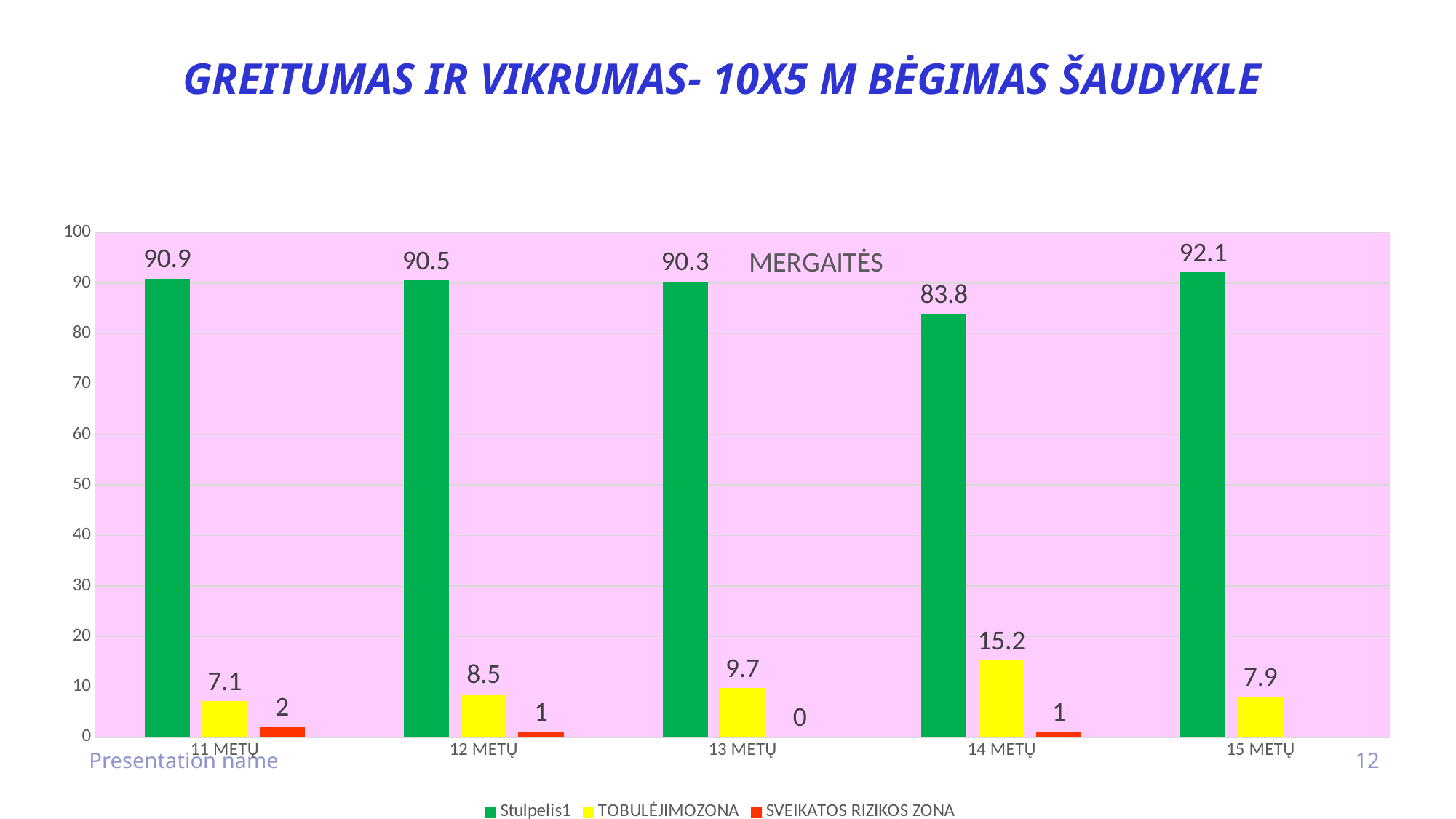
How many age groups are shown on the x axis? 5 Which age group has the highest Stulpelis1 value? 15 METŲ What colour are the TOBULĖJIMOZONA bars? Yellow What is the TOBULĖJIMOZONA value for 14 METŲ? 15.2 Which age group has the lowest Stulpelis1 value? 14 METŲ Which is larger, the TOBULĖJIMOZONA value for 12 METŲ or for 13 METŲ? 13 METŲ What is the SVEIKATOS RIZIKOS ZONA value for 11 METŲ? 2 What is the difference between the Stulpelis1 values for 15 METŲ and 14 METŲ? 8.3 How many series does the legend list? 3 What is the Stulpelis1 value for 13 METŲ? 90.3 What kind of chart is shown on the slide? Bar chart Which age group has the highest TOBULĖJIMOZONA value? 14 METŲ